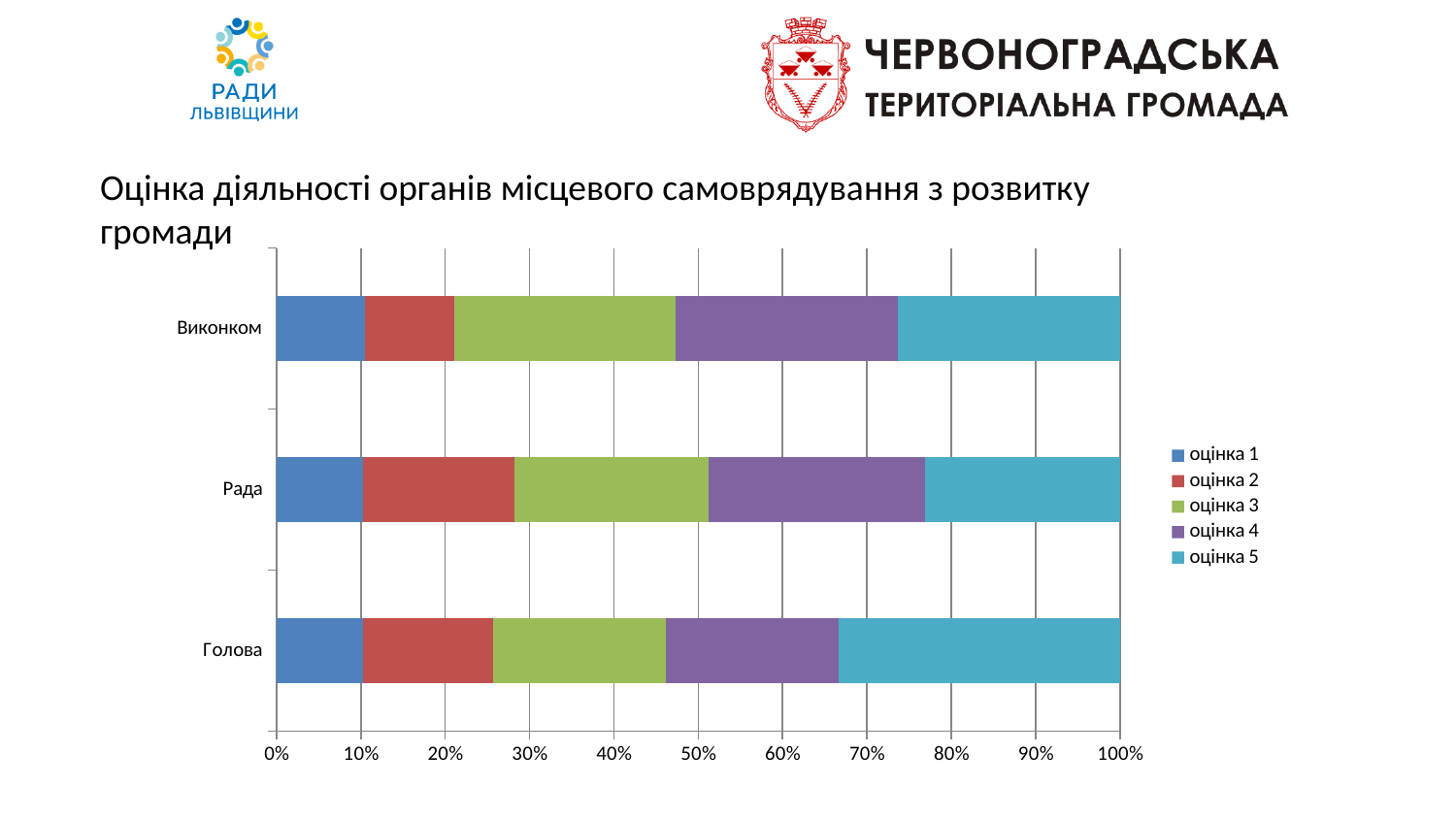
What is the total of the stacked bar for Виконком? 100% Is the оцінка 4 share for Виконком greater or less than 20%? greater How many categories are shown on the vertical axis of the chart? 3 What is the title of the chart? Оцінка діяльності органів місцевого самоврядування з розвитку громади Which has the larger оцінка 5 share, Голова or Рада? Голова Which category has the largest оцінка 5 share? Голова How many series does the legend list? 5 Which category has the smallest оцінка 2 share? Виконком What kind of chart is shown on the slide? stacked bar chart Is the оцінка 5 share for Голова greater or less than 20%? greater Which series is shown in light blue in the legend? оцінка 5 Is the оцінка 3 share for Виконком greater or less than 20%? greater